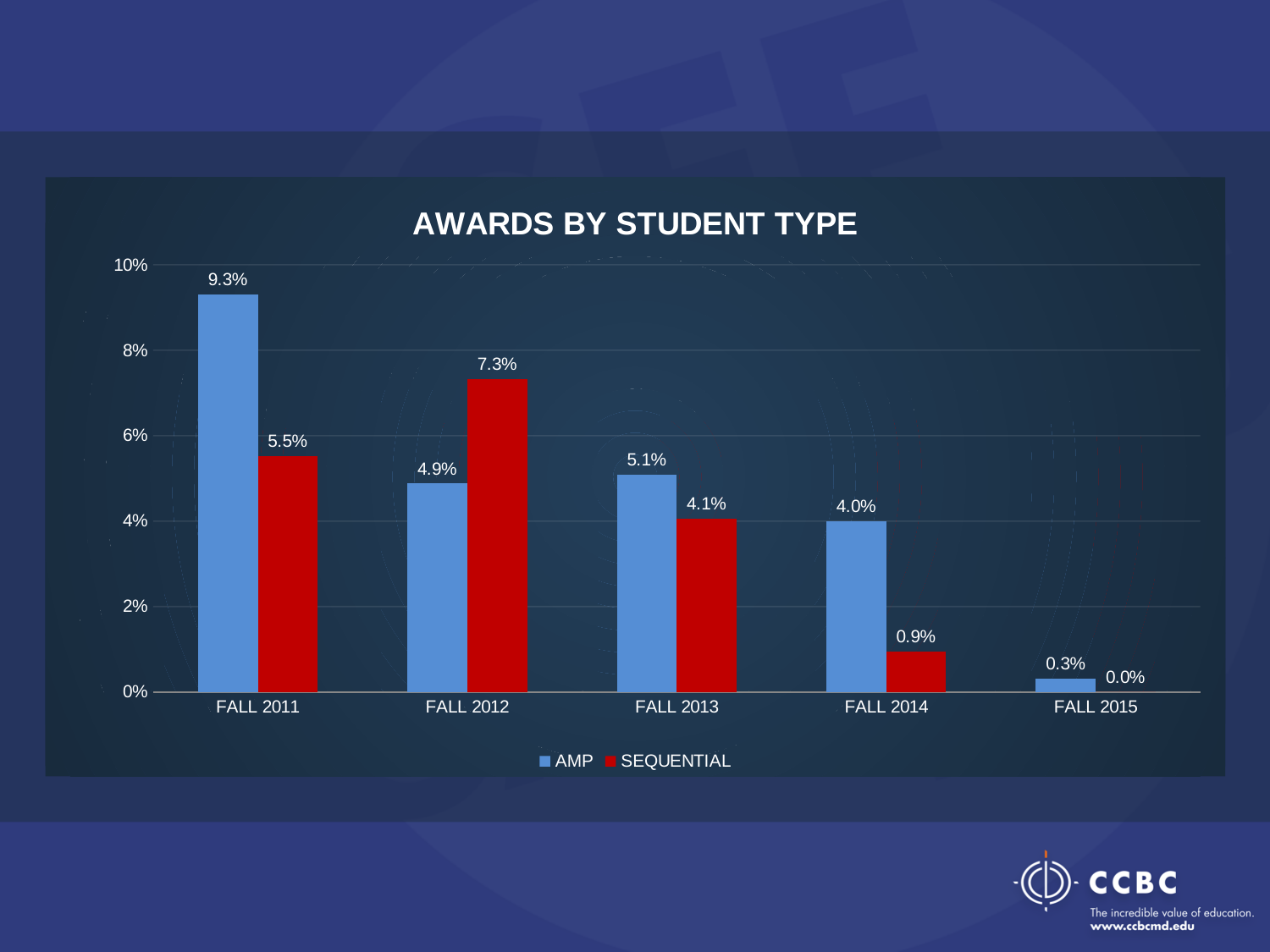
What is the title of the chart? AWARDS BY STUDENT TYPE What kind of chart is shown? Bar chart What is the AMP value for FALL 2015? 0.3% How many terms are shown on the x axis? 5 Which term has the lowest SEQUENTIAL value? FALL 2015 How many series does the legend list? 2 What is the difference between the AMP and SEQUENTIAL values for FALL 2011? 3.8% Which is larger for FALL 2012, the AMP value or the SEQUENTIAL value? SEQUENTIAL What is the SEQUENTIAL value for FALL 2012? 7.3% Which term has the highest AMP value? FALL 2011 What is the AMP value for FALL 2011? 9.3% What is the SEQUENTIAL value for FALL 2014? 0.9%